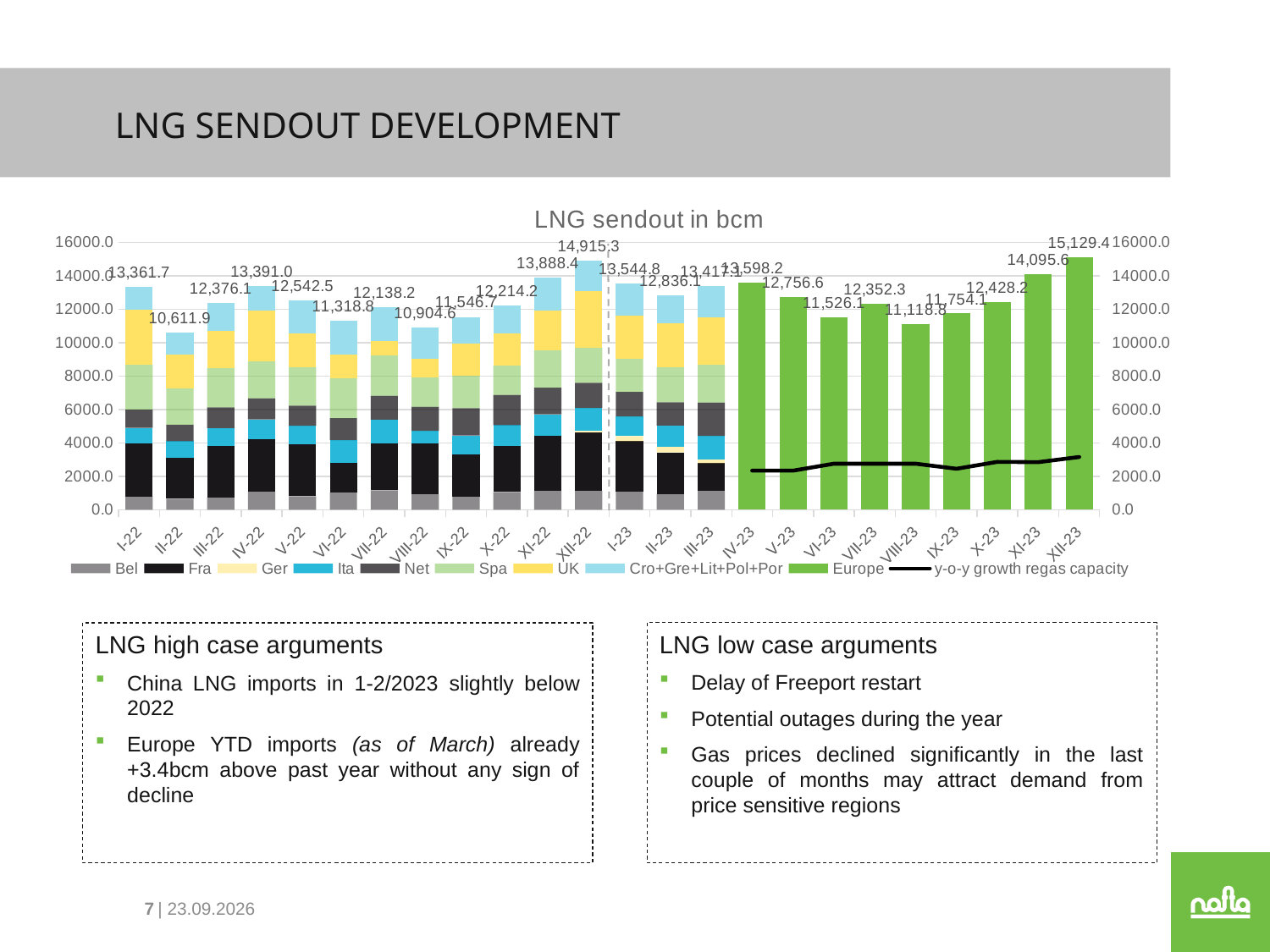
How many entries does the chart legend list? 10 Do the labelled values rise or fall from VIII-23 to XII-23? rise What is the LNG sendout value labelled for VIII-23? 11,118.8 What is the LNG sendout value labelled for XII-22? 14,915.3 How many months are shown on the x axis of the chart? 24 What is the difference between the labelled values for XII-23 and XII-22? 214.1 What is the difference between the labelled values for XII-22 and XI-22? 1,026.9 What is the LNG sendout value labelled for XII-23? 15,129.4 Which month has the lowest labelled LNG sendout value? II-22 Which month has the highest labelled LNG sendout value? XII-23 What is the LNG sendout value labelled for II-22? 10,611.9 Which is larger, the labelled value for II-22 or for VIII-22? VIII-22